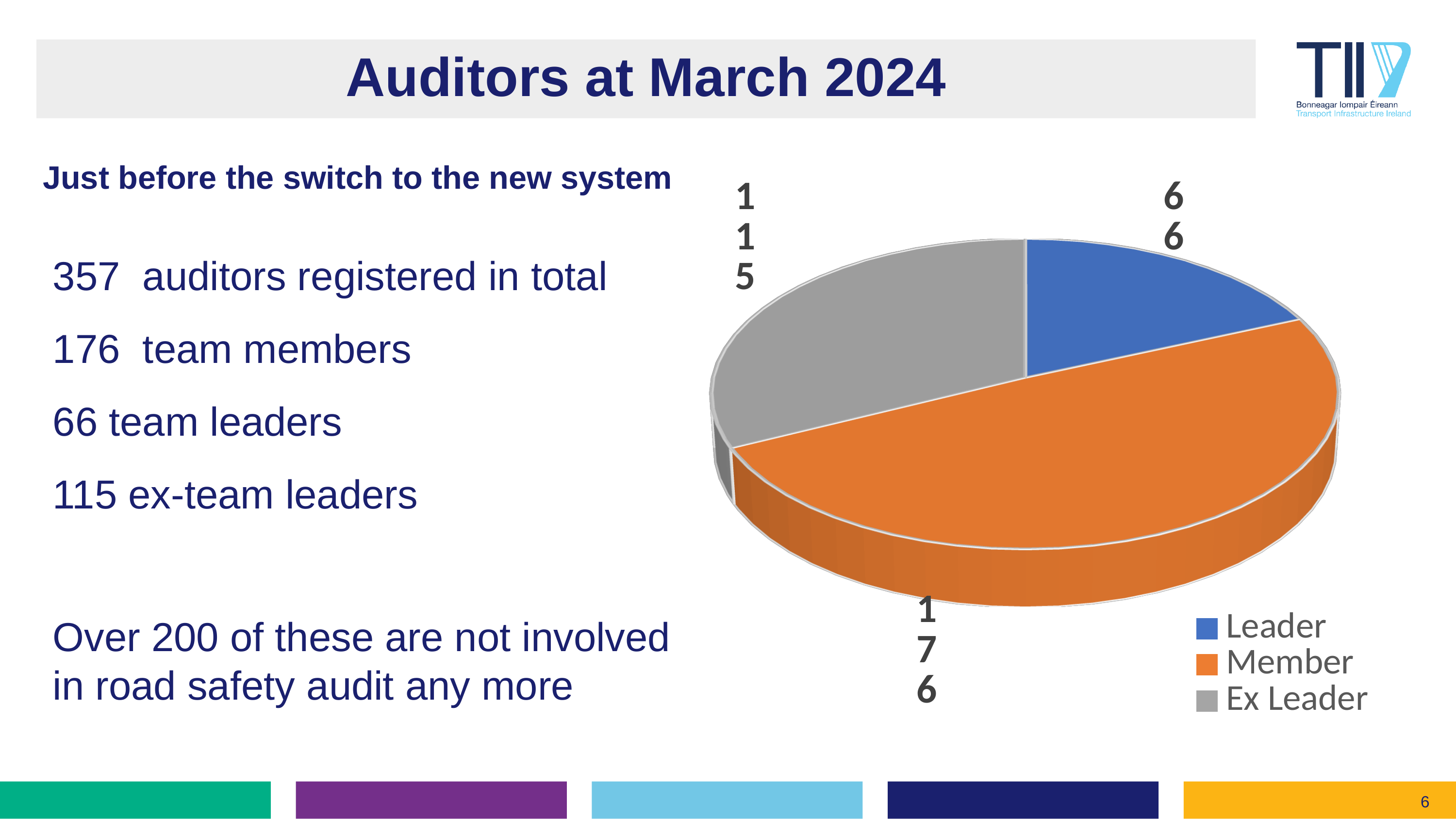
What kind of chart is shown on the slide? pie chart What is the value of the Member slice in the pie chart? 176 Which is larger in the pie chart, Ex Leader or Leader? Ex Leader What is the difference between the Member and Ex Leader values in the pie chart? 61 How many entries does the legend of the pie chart list? 3 What is the total of all slices in the pie chart? 357 What is the value of the Ex Leader slice in the pie chart? 115 Which colour represents Ex Leader in the pie chart? grey Which category has the largest slice in the pie chart? Member What is the value of the Leader slice in the pie chart? 66 Which category has the smallest slice in the pie chart? Leader How many slices does the pie chart have? 3